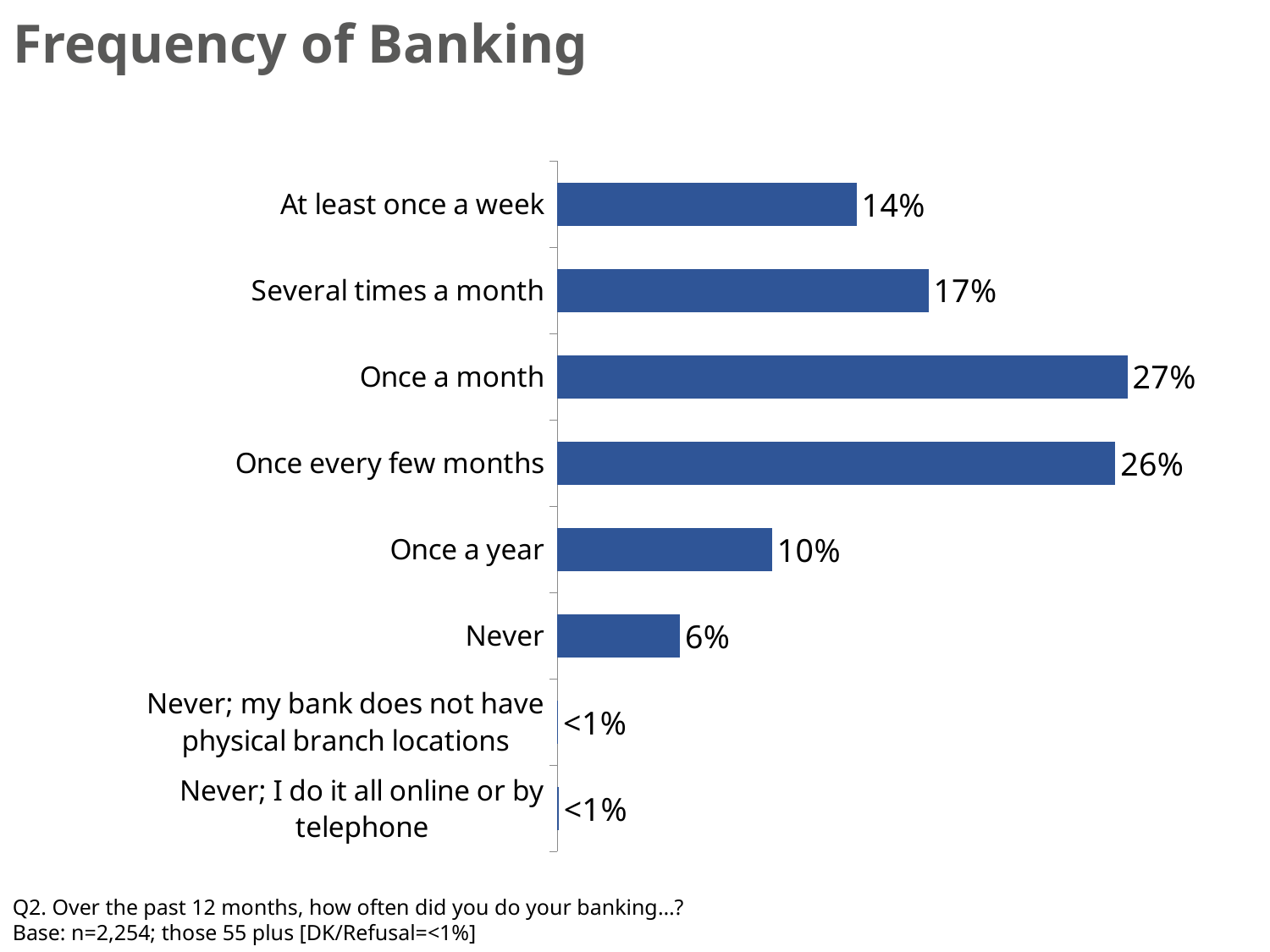
Which is larger, the value for 'Several times a month' or the value for 'Once a year'? Several times a month What is the difference between the values for 'Once a month' and 'Once a year'? 17% What is the value for 'Once every few months'? 26% What is the difference between 'Several times a month' and 'At least once a week'? 3% Among the categories with a numeric value printed, which has the lowest value? Never Which category has the highest value? Once a month How many categories are shown on the chart? 8 What percentage of respondents do their banking at least once a week? 14% What is the title of the slide? Frequency of Banking What percentage of respondents said they never do their banking (the plain 'Never' category)? 6% What kind of chart is shown on the slide? Bar chart What is the value shown for 'Never; I do it all online or by telephone'? <1%